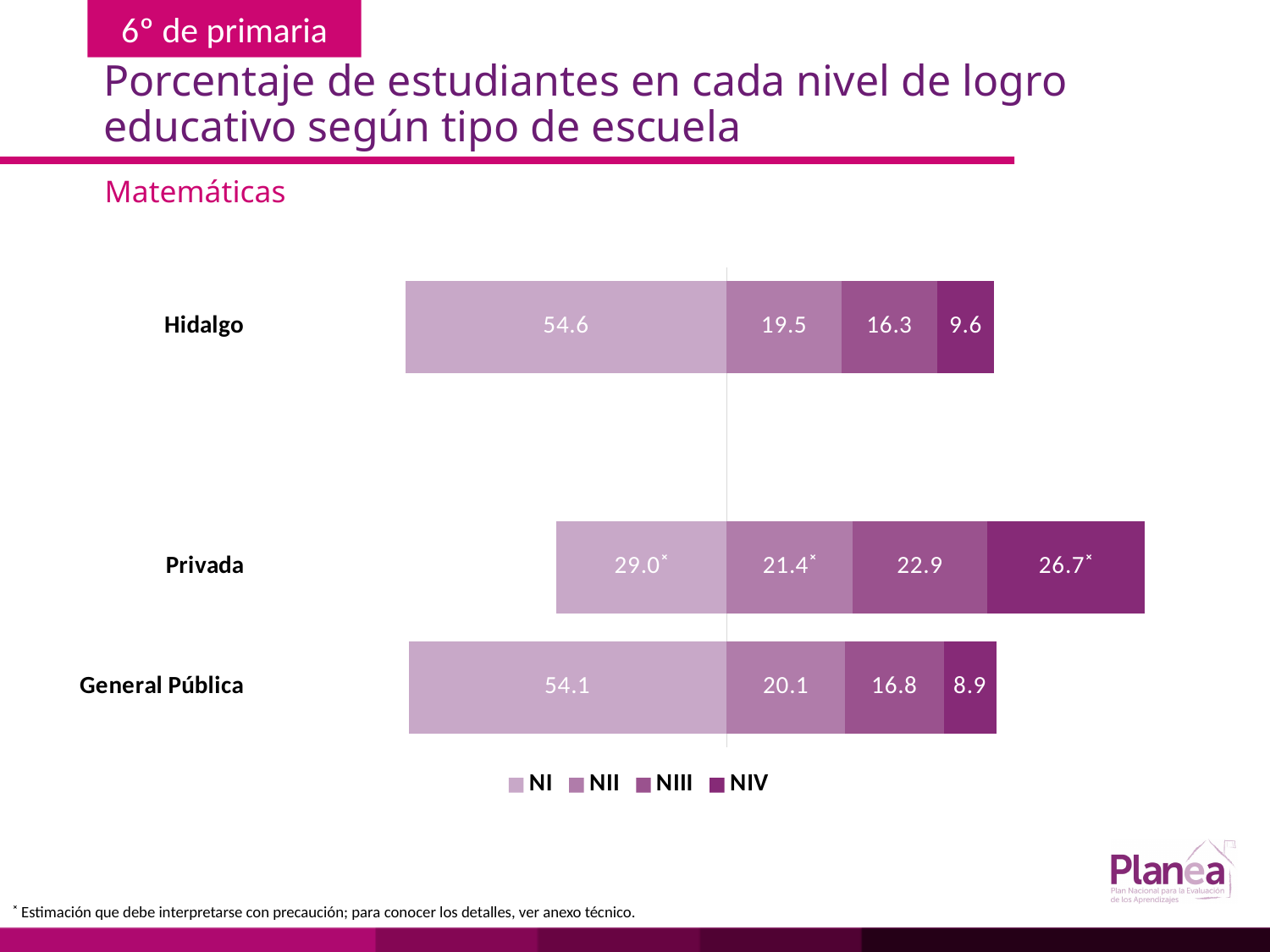
Which school type has the highest NIV percentage? Privada What is the NIII value for General Pública schools? 16.8 How many series does the legend list? 4 What kind of chart is shown on the slide? Stacked bar chart What is the difference between the NI value for Hidalgo and the NI value for General Pública? 0.5 Which is larger, the NII value for General Pública or the NII value for Hidalgo? General Pública What is the NIV value for Privada schools? 26.7 Which school type has the lowest NI percentage? Privada What percentage of Hidalgo students are at level NI in Matemáticas? 54.6 What is the difference between the NIV value for Privada and the NIV value for Hidalgo? 17.1 How many school types (categories) are shown in the chart? 3 What is the NII value for Hidalgo? 19.5